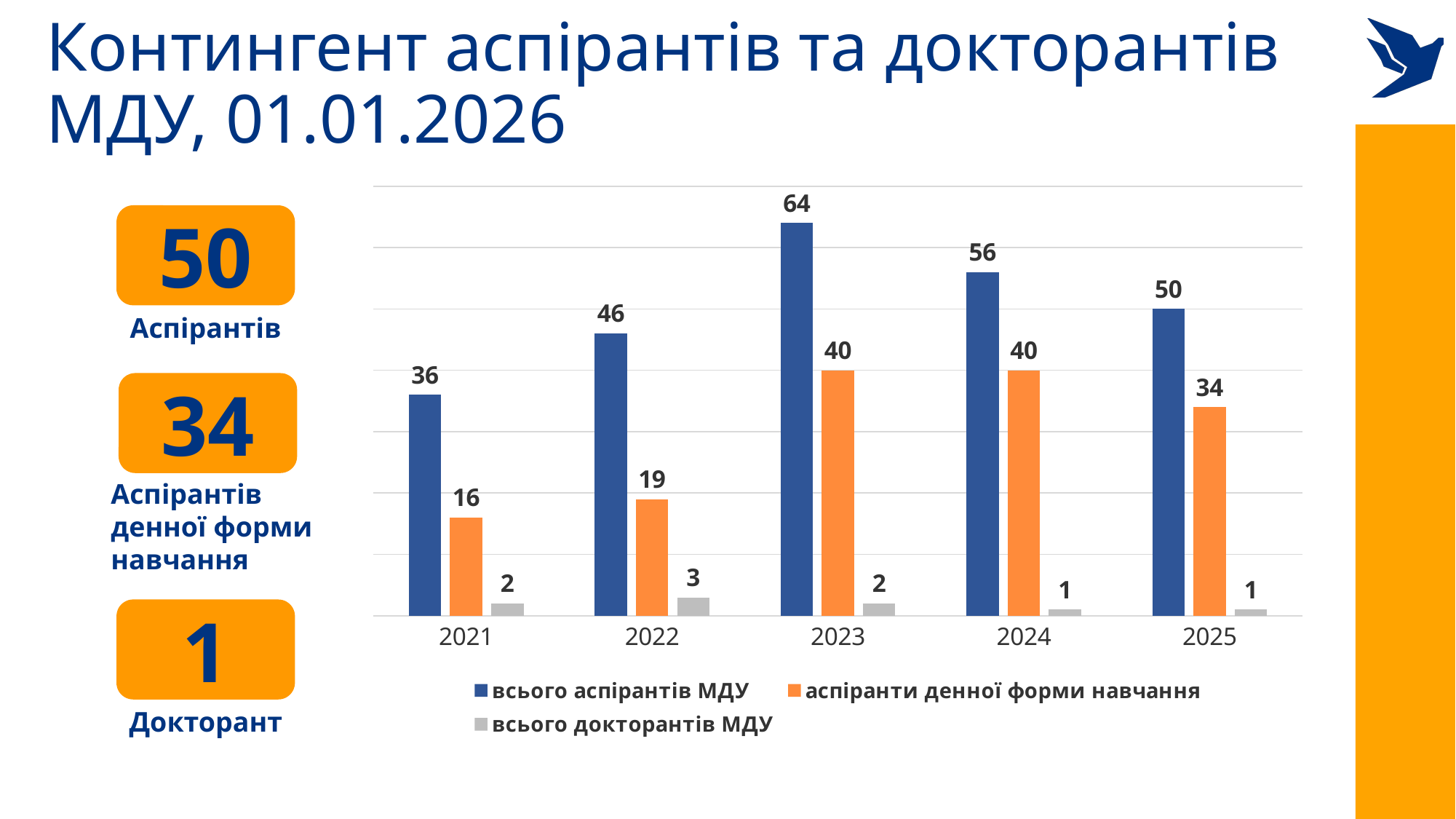
What is the difference between 'всього аспірантів МДУ' and 'аспіранти денної форми навчання' in 2025? 16 How many series does the legend list? 3 Which series is shown in orange in the legend? аспіранти денної форми навчання What is the value for 'всього аспірантів МДУ' in 2023? 64 How many years are shown on the x axis? 5 Does 'всього аспірантів МДУ' rise or fall from 2021 to 2023? rise Which is larger: 'всього аспірантів МДУ' in 2022 or in 2024? 2024 In which year is 'аспіранти денної форми навчання' lowest? 2021 What is the value for 'всього докторантів МДУ' in 2022? 3 In which year is 'всього аспірантів МДУ' highest? 2023 What is the value for 'аспіранти денної форми навчання' in 2021? 16 What kind of chart is shown on the slide? bar chart